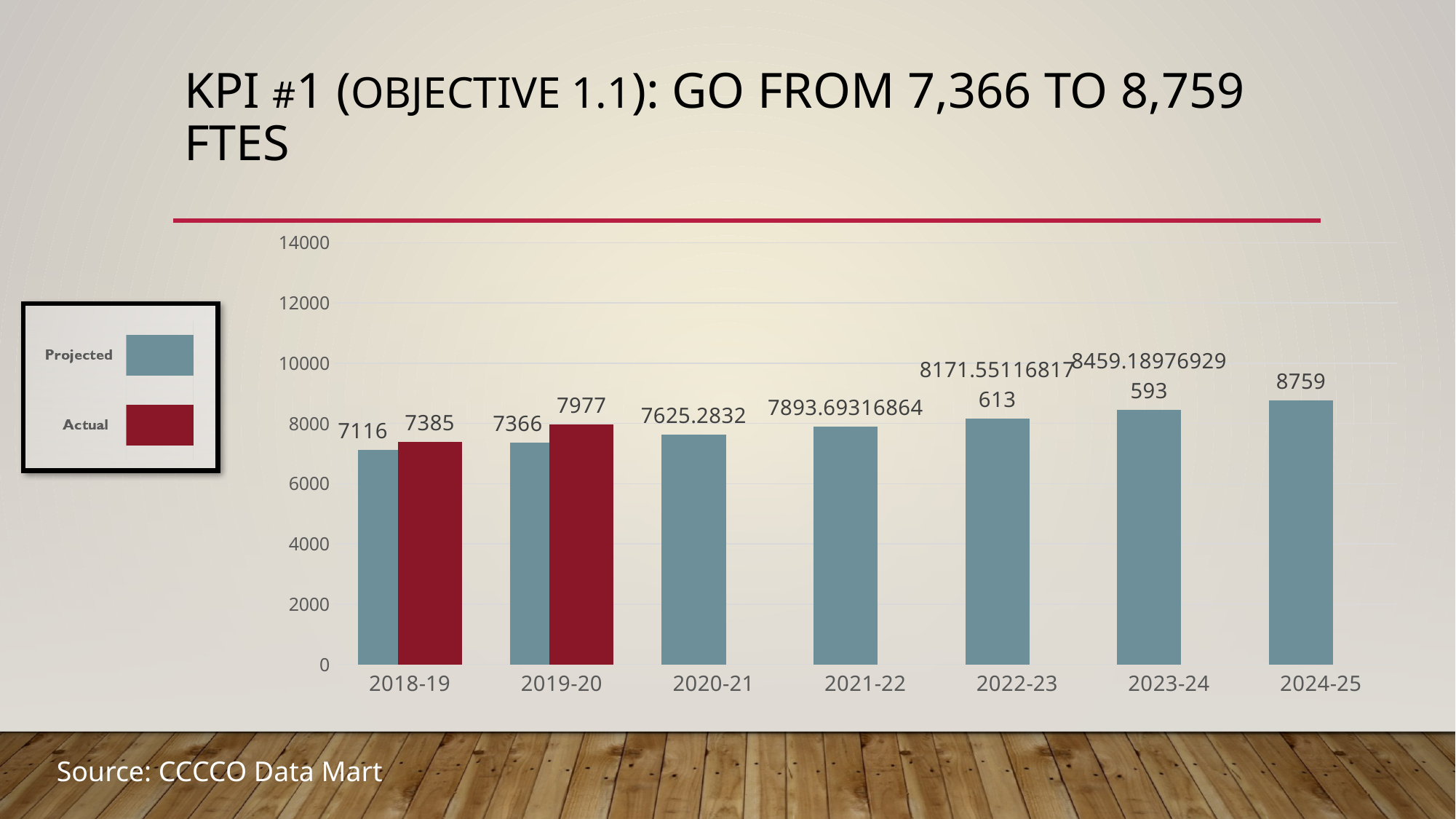
What is the Actual value for 2019-20? 7977 Which is larger for 2018-19, the Projected value or the Actual value? Actual Which year has the highest Projected value? 2024-25 What is the Projected value for 2018-19? 7116 What is the difference between the Actual and Projected values for 2018-19? 269 How many years are shown on the x axis? 7 What is the Projected value for 2024-25? 8759 How many series does the legend list? 2 What is the Projected value for 2020-21? 7625.2832 What is the difference between the Actual and Projected values for 2019-20? 611 Is the Projected value for 2023-24 greater or less than 8000? greater Which year has the lowest Projected value? 2018-19